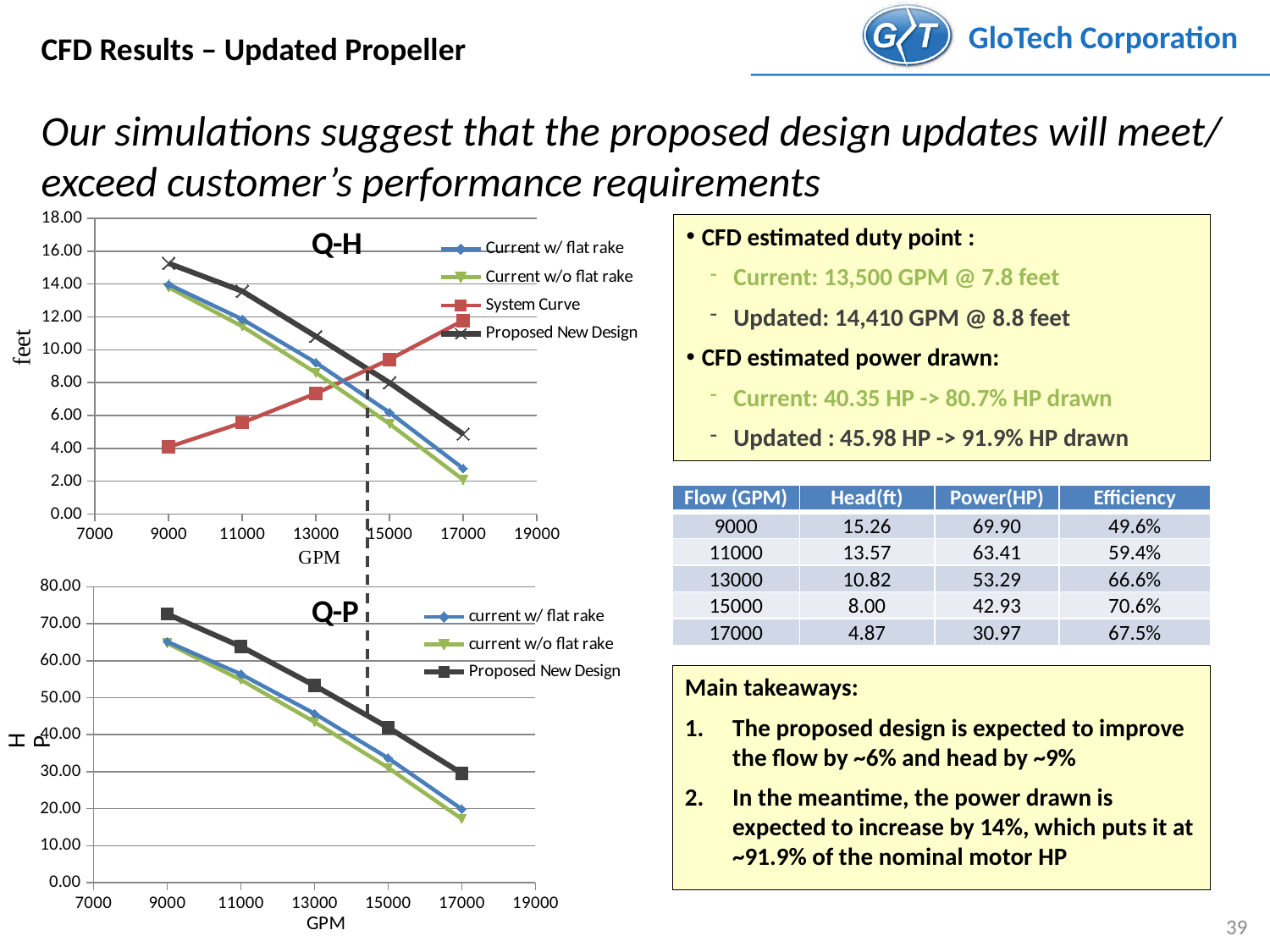
How many series does the legend of the Q-H chart list? 4 In the Q-H chart, how many data points does the Proposed New Design series have? 5 In the Q-H chart, does the Proposed New Design series rise or fall as GPM increases? Falls How many series does the legend of the Q-P chart list? 3 In the Q-P chart, is the Proposed New Design value at 9000 GPM greater or less than 70.00? greater In the Q-H chart, does the System Curve rise or fall as GPM increases? Rises In the Q-H chart, is the System Curve value at 9000 GPM greater or less than 6.00? less What kind of chart is the Q-H chart at the top left of the slide? Line chart In the Q-P chart, which series has the highest value at 13000 GPM? Proposed New Design What is the label on the vertical axis of the Q-H chart? feet In the Q-P chart, is the current w/ flat rake value at 17000 GPM greater or less than 30.00? less In the Q-H chart, at 17000 GPM, which is higher: Proposed New Design or Current w/o flat rake? Proposed New Design